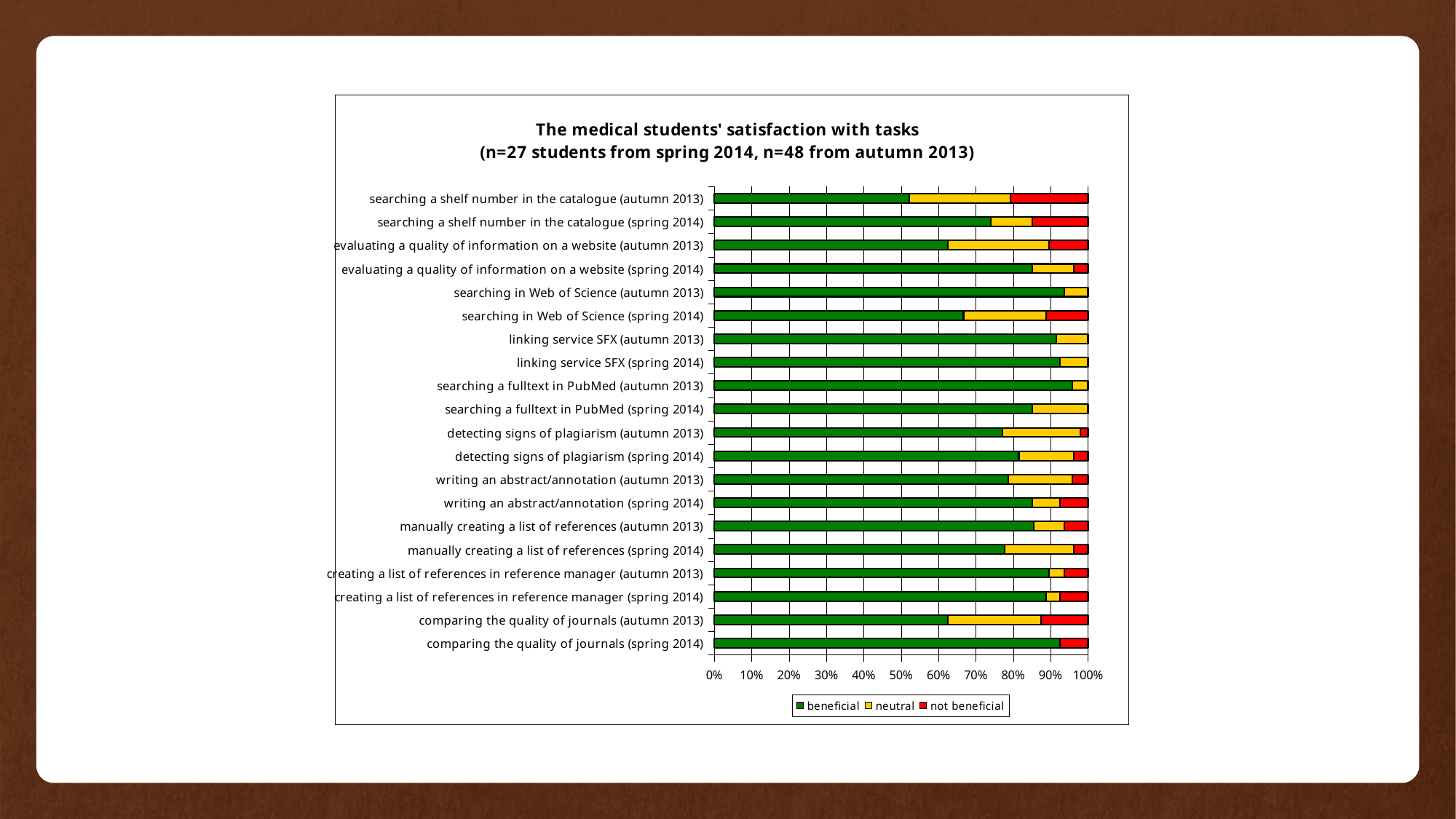
Which colour represents the neutral series in the legend? yellow Which category has the largest not beneficial share? searching a shelf number in the catalogue (autumn 2013) Which has the larger beneficial share: searching in Web of Science (autumn 2013) or searching in Web of Science (spring 2014)? searching in Web of Science (autumn 2013) Is the beneficial share for searching a shelf number in the catalogue (autumn 2013) greater or less than 60%? less What is the total of the stacked bar for linking service SFX (spring 2014)? 100% How many series does the legend list? 3 What kind of chart is shown on the slide? stacked bar chart Which has the larger beneficial share: searching a shelf number in the catalogue (spring 2014) or searching a shelf number in the catalogue (autumn 2013)? searching a shelf number in the catalogue (spring 2014) Is the beneficial share for comparing the quality of journals (autumn 2013) greater or less than 70%? less Is the beneficial share for searching in Web of Science (autumn 2013) greater or less than 90%? greater Which category has the smallest beneficial share? searching a shelf number in the catalogue (autumn 2013) How many task categories are plotted on the chart? 20